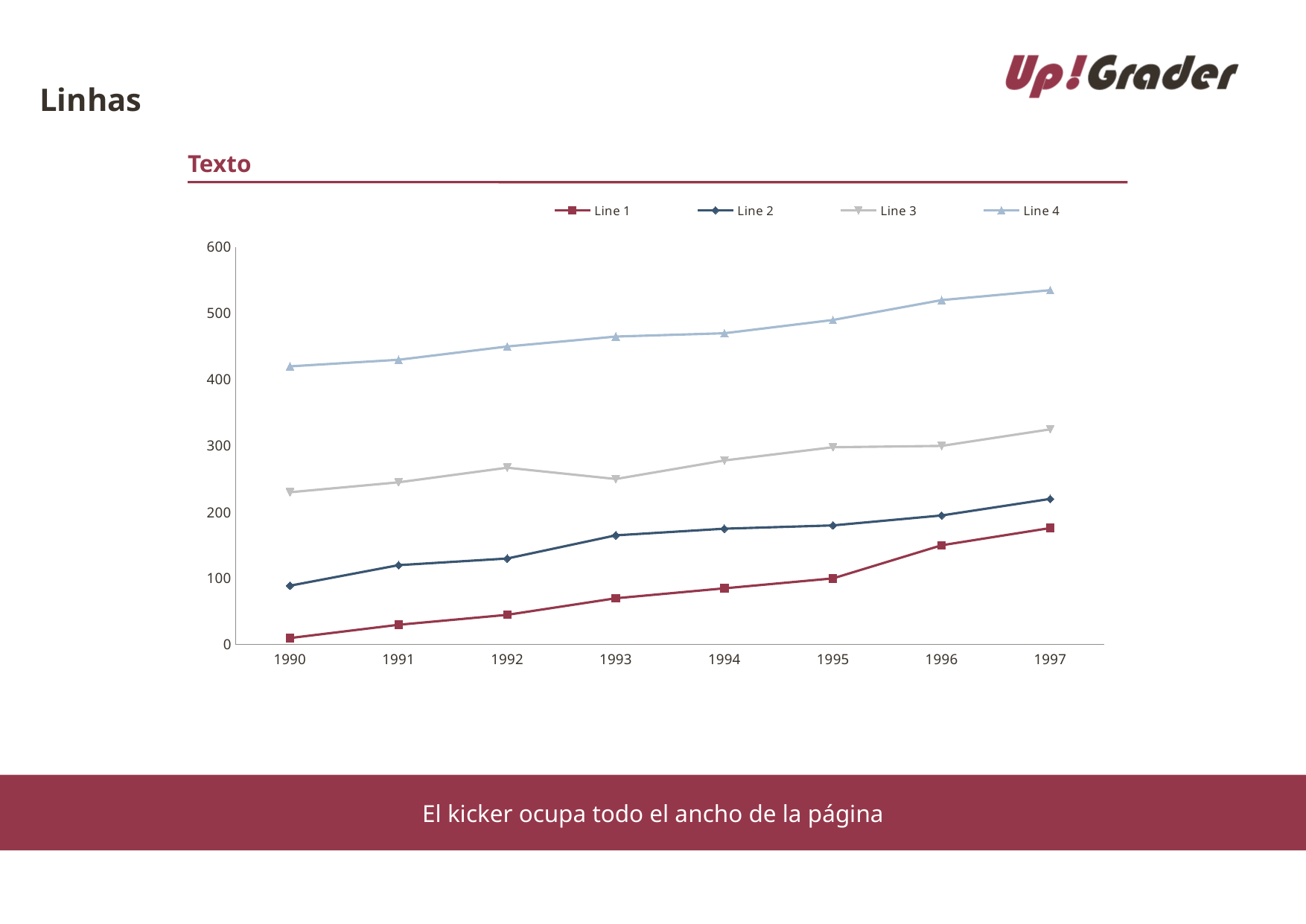
Is the value for Line 2 in 1997 greater or less than 200? greater Is the value for Line 1 in 1990 greater or less than 100? less What is the first year shown on the x axis? 1990 What kind of chart is shown on the slide? line chart How many years are shown on the x axis? 8 Is the value for Line 3 in 1990 greater or less than 200? greater Which series has the highest values across all years? Line 4 Does Line 4 generally rise or fall from 1990 to 1997? rise Which series has the lowest values across all years? Line 1 How many series does the legend list? 4 Which is larger in 1993, the value for Line 2 or the value for Line 1? Line 2